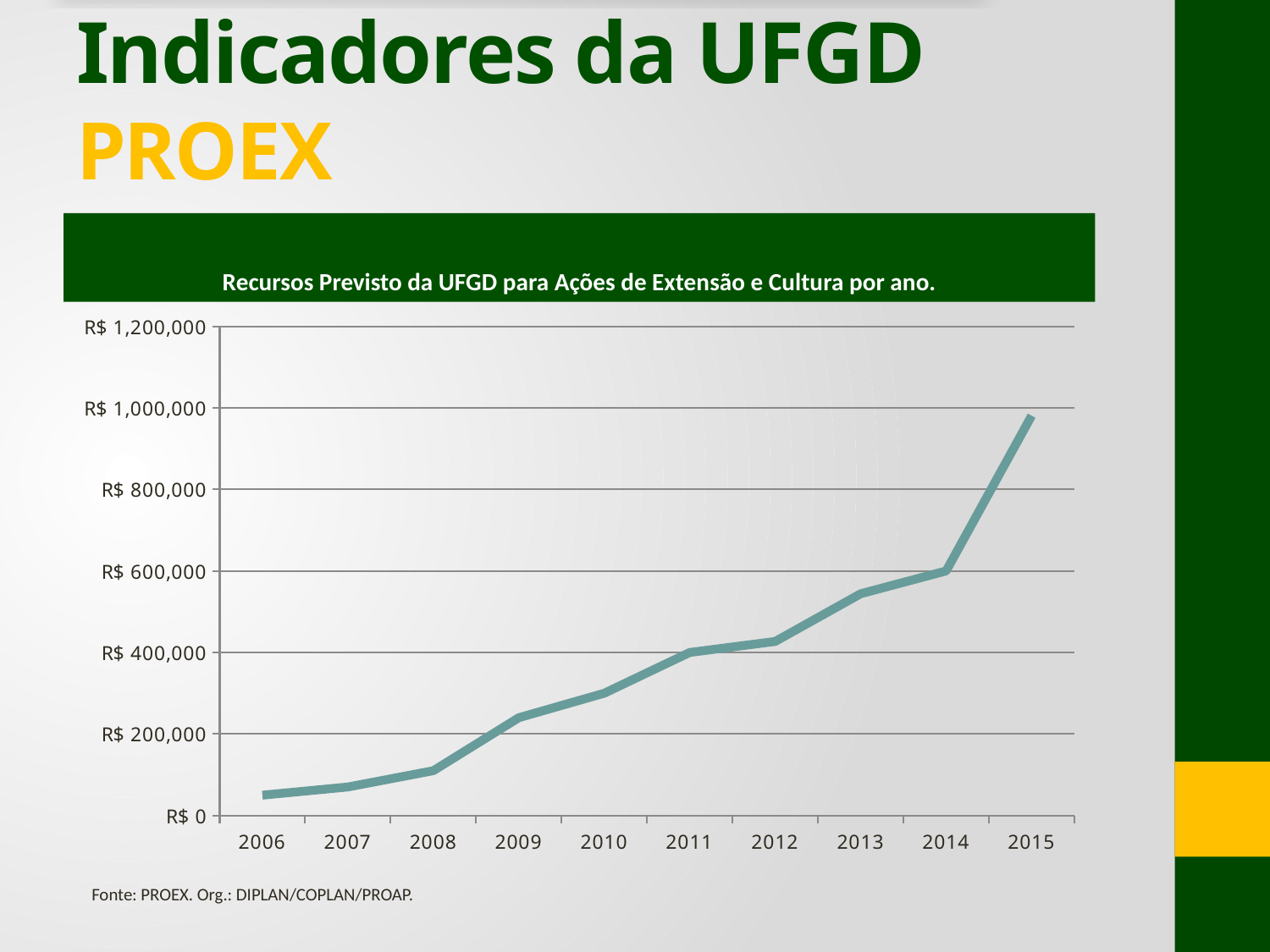
Is the value for 2010 greater or less than R$ 400,000? less Which year has the larger value, 2014 or 2015? 2015 Is the value for 2015 greater or less than R$ 800,000? greater Which year has the lowest value in the chart? 2006 Is the value for 2013 greater or less than R$ 600,000? less Which year has the highest value in the chart? 2015 What kind of chart is shown on the slide? line chart How many years are plotted on the x axis of the chart? 10 What is the title of the chart? Recursos Previsto da UFGD para Ações de Extensão e Cultura por ano. Do the values rise or fall from 2006 to 2015? rise